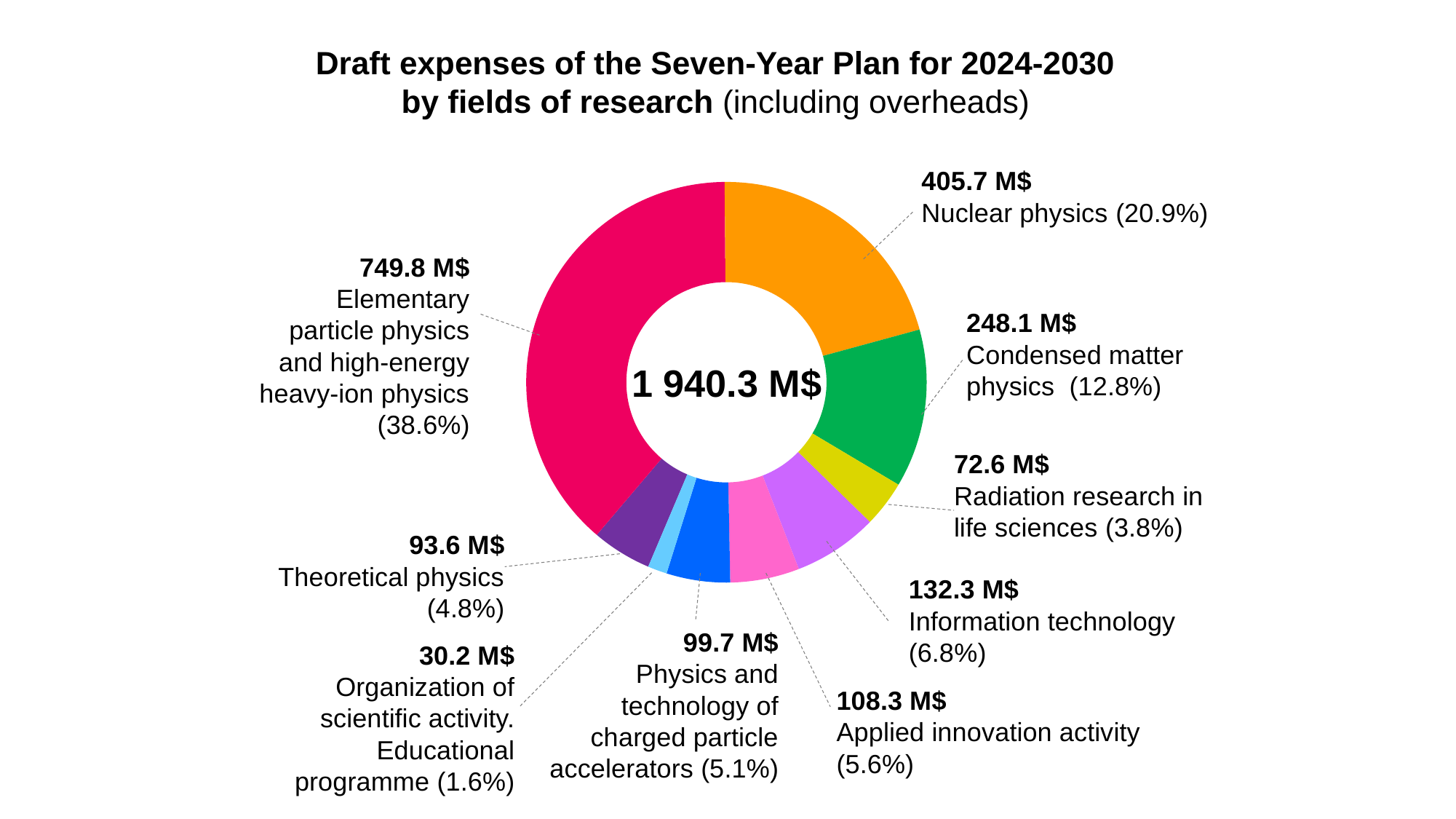
Which field of research has the smallest draft expense? Organization of scientific activity. Educational programme What is the draft expense for Theoretical physics? 93.6 M$ Which field of research has the largest draft expense? Elementary particle physics and high-energy heavy-ion physics What share of the total does Radiation research in life sciences account for? 3.8% What is the difference between the expenses for Nuclear physics and Condensed matter physics? 157.6 M$ What is the draft expense for Nuclear physics? 405.7 M$ What kind of chart is shown on the slide? Pie chart (doughnut) How many fields of research are shown in the chart? 9 Which has a larger draft expense, Information technology or Applied innovation activity? Information technology What share of the total does Condensed matter physics account for? 12.8% What is the title of the chart? Draft expenses of the Seven-Year Plan for 2024-2030 by fields of research (including overheads) What is the total of all draft expenses shown in the centre of the chart? 1 940.3 M$